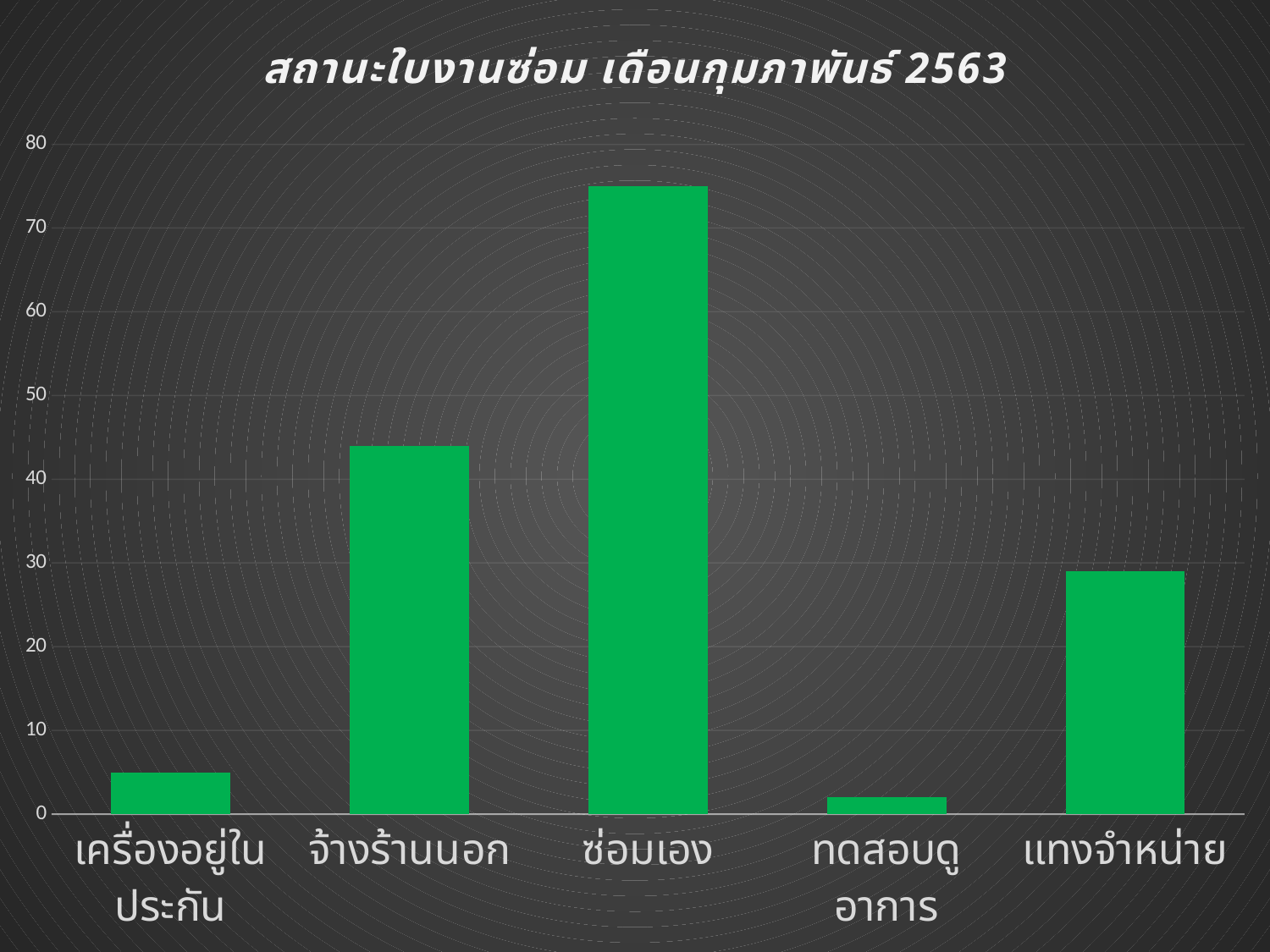
What colour are the bars in the chart? green Which is larger, the value for จ้างร้านนอก or the value for แทงจำหน่าย? จ้างร้านนอก What is the title of the chart? สถานะใบงานซ่อม เดือนกุมภาพันธ์ 2563 Which is larger, the value for เครื่องอยู่ในประกัน or the value for ทดสอบดูอาการ? เครื่องอยู่ในประกัน Which category has the lowest value? ทดสอบดูอาการ How many categories are shown on the x axis of the chart? 5 Is the value for เครื่องอยู่ในประกัน greater or less than 10? less Is the value for จ้างร้านนอก greater or less than 50? less Is the value for ซ่อมเอง greater or less than 70? greater Which category has the highest value? ซ่อมเอง What kind of chart is shown on the slide? bar chart